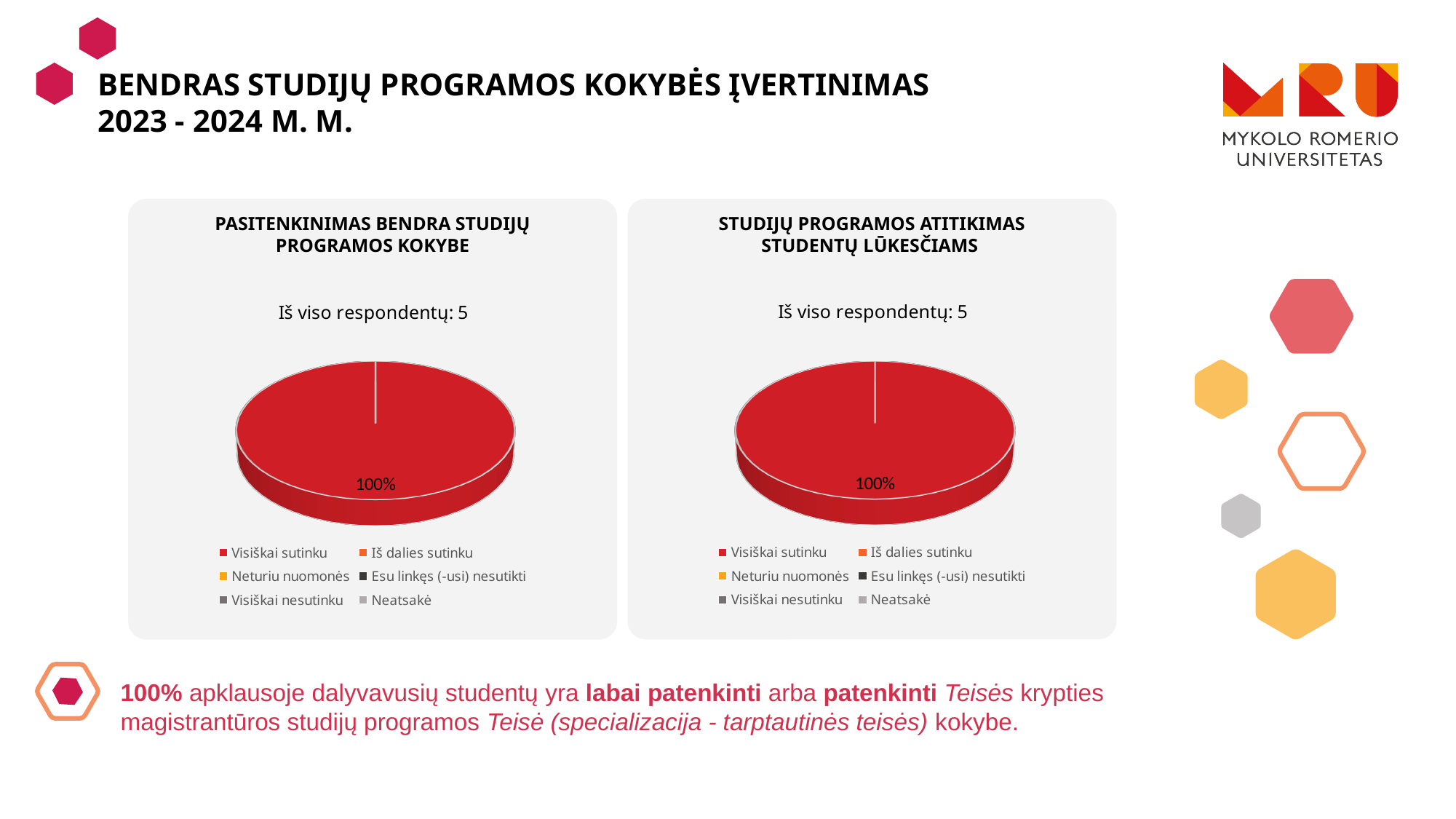
In the chart "PASITENKINIMAS BENDRA STUDIJŲ PROGRAMOS KOKYBE", what share of the pie does the "Visiškai sutinku" slice take? 100% In the chart "STUDIJŲ PROGRAMOS ATITIKIMAS STUDENTŲ LŪKESČIAMS", what share of the pie does the "Visiškai sutinku" slice take? 100% What kind of chart is shown under the title "PASITENKINIMAS BENDRA STUDIJŲ PROGRAMOS KOKYBE"? Pie chart How many respondents are reported for the chart "PASITENKINIMAS BENDRA STUDIJŲ PROGRAMOS KOKYBE"? 5 How many respondents are reported for the chart "STUDIJŲ PROGRAMOS ATITIKIMAS STUDENTŲ LŪKESČIAMS"? 5 How many entries does the legend list in the chart "PASITENKINIMAS BENDRA STUDIJŲ PROGRAMOS KOKYBE"? 6 What colour is the "Visiškai sutinku" slice in the chart "PASITENKINIMAS BENDRA STUDIJŲ PROGRAMOS KOKYBE"? Red What is the title of the right-hand chart on the slide? STUDIJŲ PROGRAMOS ATITIKIMAS STUDENTŲ LŪKESČIAMS How many entries does the legend list in the chart "STUDIJŲ PROGRAMOS ATITIKIMAS STUDENTŲ LŪKESČIAMS"? 6 In the chart "PASITENKINIMAS BENDRA STUDIJŲ PROGRAMOS KOKYBE", which legend category has the largest share of the pie? Visiškai sutinku In the chart "STUDIJŲ PROGRAMOS ATITIKIMAS STUDENTŲ LŪKESČIAMS", which legend category has the largest share of the pie? Visiškai sutinku How many slices are visible in the pie of the chart "STUDIJŲ PROGRAMOS ATITIKIMAS STUDENTŲ LŪKESČIAMS"? 1